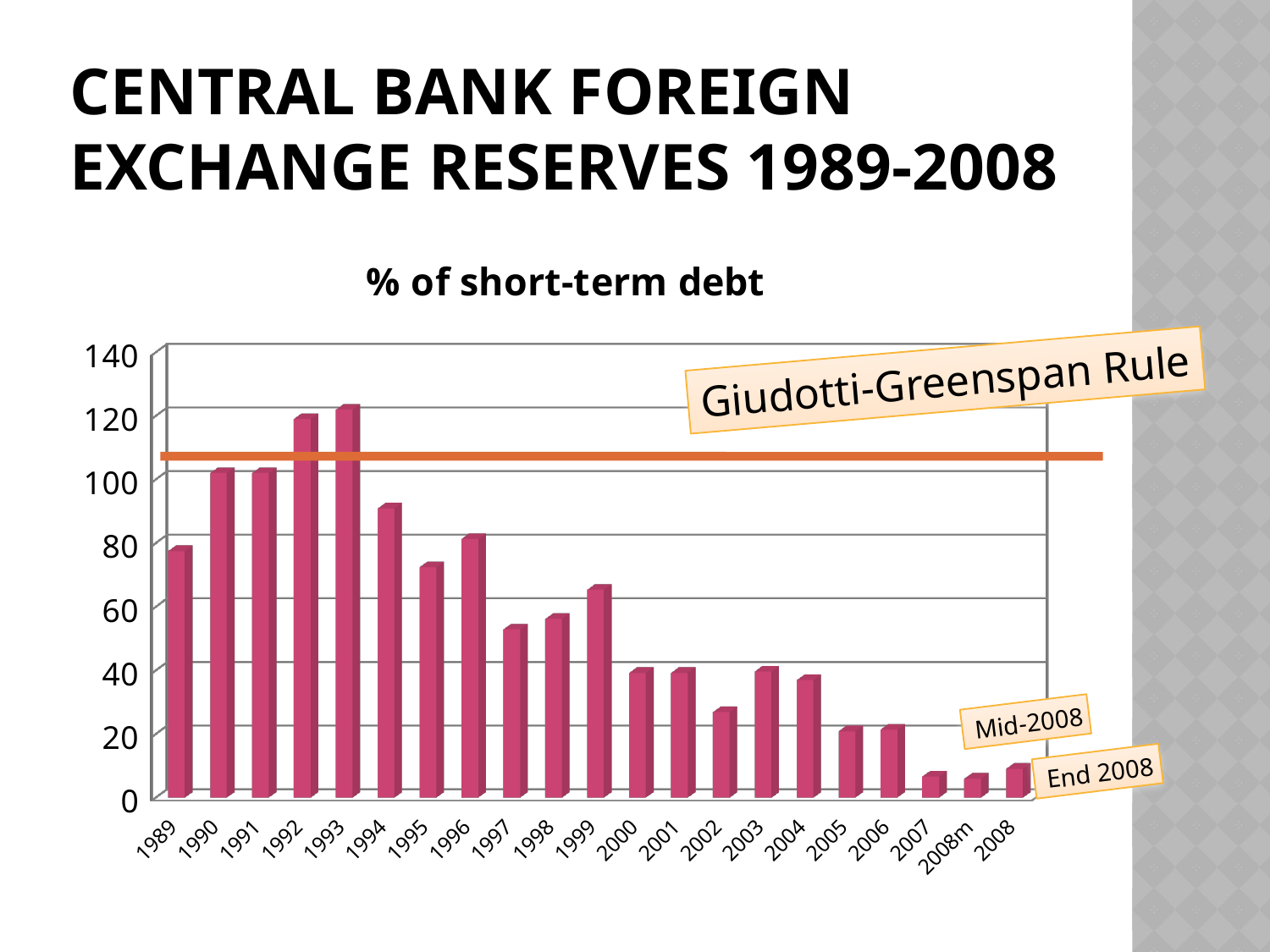
How many years (categories) are plotted along the x axis? 21 Do the values generally rise or fall from 1993 to 2008? fall What kind of chart is shown on the slide? bar chart Which is larger, the value for 2002 or the value for 2003? 2003 Is the value for 1994 greater or less than 80? greater Is the value for 1995 greater or less than 80? less Which year has the highest bar? 1993 Is the value for 1992 greater or less than 100? greater What is the label on the horizontal orange line across the chart? Giudotti-Greenspan Rule Which is larger, the value for 1996 or the value for 1997? 1996